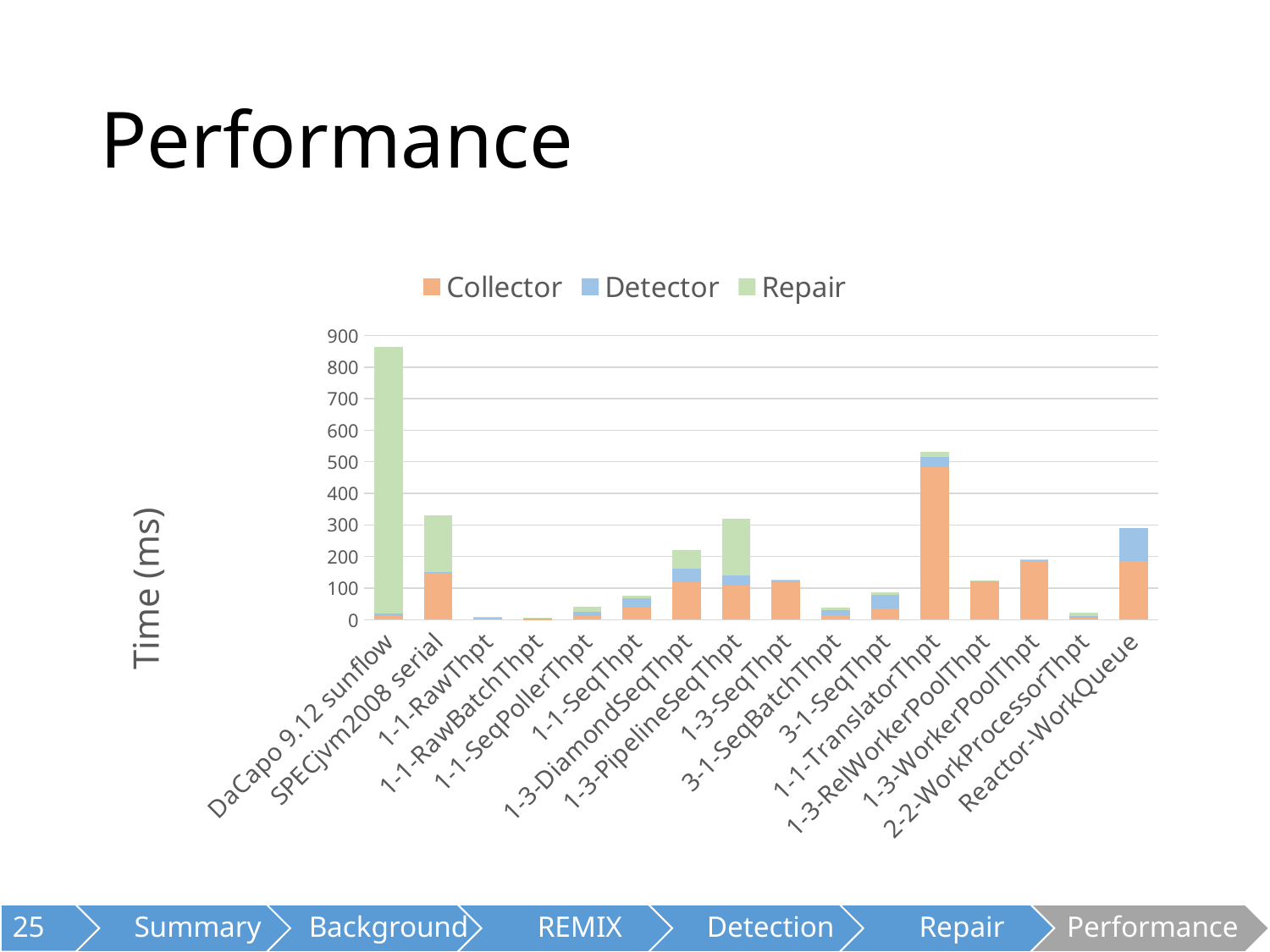
How many series does the legend list? 3 What is the label on the y axis? Time (ms) Which has the larger total bar, 1-1-TranslatorThpt or SPECjvm2008 serial? 1-1-TranslatorThpt How many benchmark categories are plotted along the x axis? 16 Which series is shown in green in the legend? Repair What kind of chart is shown on the slide? stacked bar chart Which category has the tallest stacked bar? DaCapo 9.12 sunflow Is the total value for 1-1-TranslatorThpt greater or less than 500? greater Which has the larger total bar, 1-3-PipelineSeqThpt or 1-3-SeqThpt? 1-3-PipelineSeqThpt Is the total value for DaCapo 9.12 sunflow greater or less than 800? greater